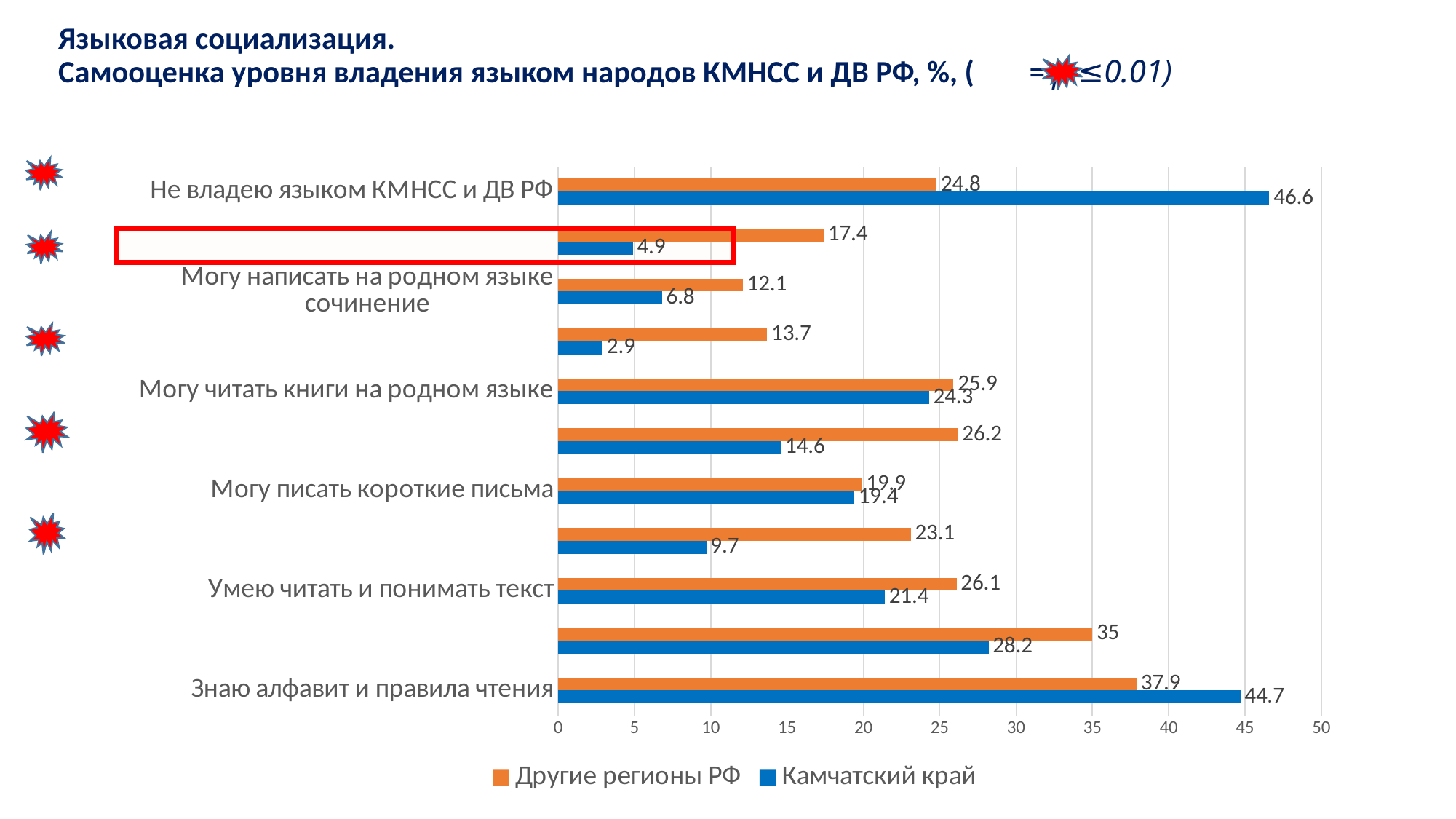
How many categories are plotted on the chart? 11 What type of chart is shown on the slide? Bar chart What is the value for Камчатский край in the category 'Могу написать на родном языке сочинение'? 6.8 What is the value for Другие регионы РФ in the category 'Знаю алфавит и правила чтения'? 37.9 Which category has the lowest value for Другие регионы РФ? Могу написать на родном языке сочинение What is the value for Другие регионы РФ in the category 'Умею читать и понимать текст'? 26.1 What is the difference between Другие регионы РФ and Камчатский край in the category 'Могу читать книги на родном языке'? 1.6 How many series does the legend list? 2 In the category 'Знаю алфавит и правила чтения', which series has the larger value? Камчатский край Which category has the highest value for Другие регионы РФ? Знаю алфавит и правила чтения What is the value for Камчатский край in the category 'Не владею языком КМНСС и ДВ РФ'? 46.6 Which category has the highest value for Камчатский край? Не владею языком КМНСС и ДВ РФ